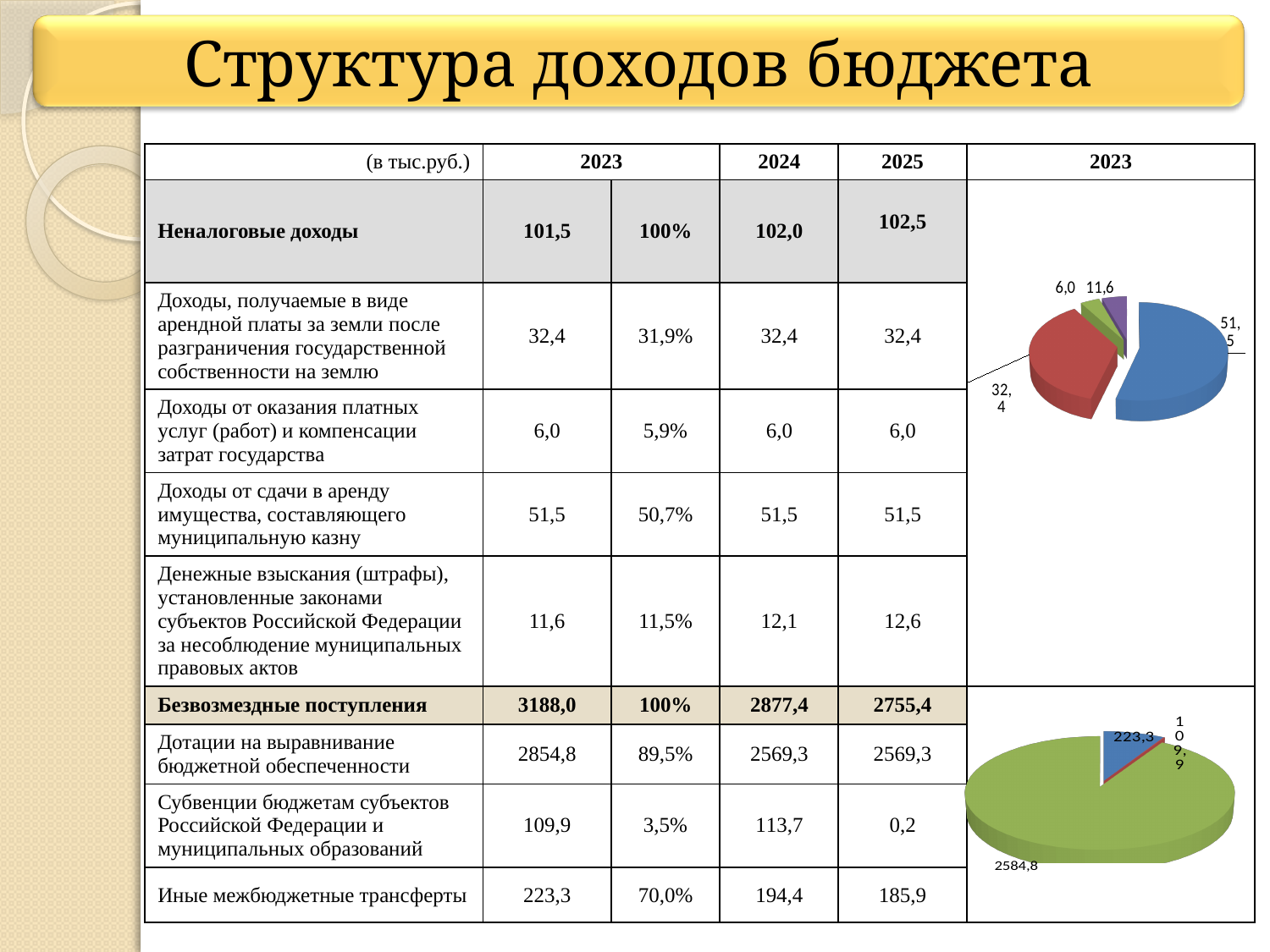
In the bottom pie chart, how many slices are there? 3 In the top pie chart (2023), what is the difference between the largest slice (51,5) and the smallest slice (6,0)? 45,5 In the top pie chart (2023), how many slices are there? 4 In the bottom pie chart, which slice is larger: the one labelled 223,3 or the one labelled 109,9? 223,3 In the top pie chart (2023), which slice is larger: the one labelled 32,4 or the one labelled 11,6? 32,4 In the bottom pie chart, what is the value label of the largest slice? 2584,8 In the top pie chart (2023), what is the value of the largest slice? 51,5 In the top pie chart (2023), what colour is the largest slice (51,5)? blue In the bottom pie chart, what colour is the largest slice? green In the top pie chart (2023), what is the value of the smallest slice? 6,0 What type of chart is shown on the right side of the slide under the 2023 heading (top chart)? pie chart In the bottom pie chart, what is the value label of the smallest slice? 109,9